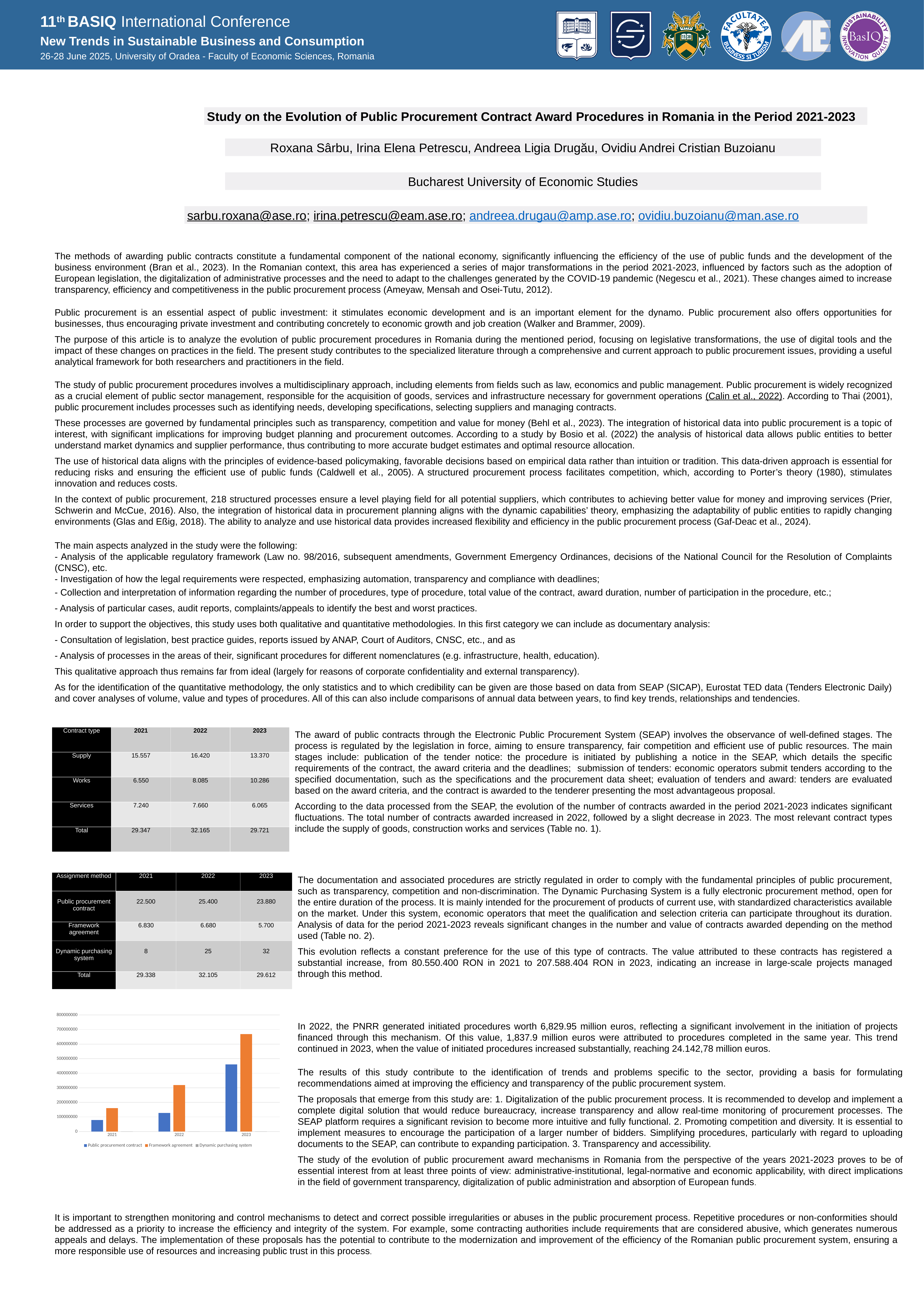
In the bar chart, which year has the highest Framework agreement bar? 2023 In the bar chart, is the Framework agreement value for 2022 greater or less than 200000000? greater In the bar chart, which is larger in 2022: Framework agreement or Public procurement contract? Framework agreement In the bar chart, which year has the lowest Public procurement contract bar? 2021 How many year categories are shown on the x axis of the bar chart? 3 In the bar chart, is the Public procurement contract value for 2023 greater or less than 400000000? greater What kind of chart is shown at the bottom left of the slide? bar chart In the bar chart, which colour represents the Framework agreement series? orange In the bar chart, is the Public procurement contract value for 2021 greater or less than 100000000? less How many series does the legend of the bar chart list? 3 In the bar chart, do the Public procurement contract values rise or fall from 2021 to 2023? rise